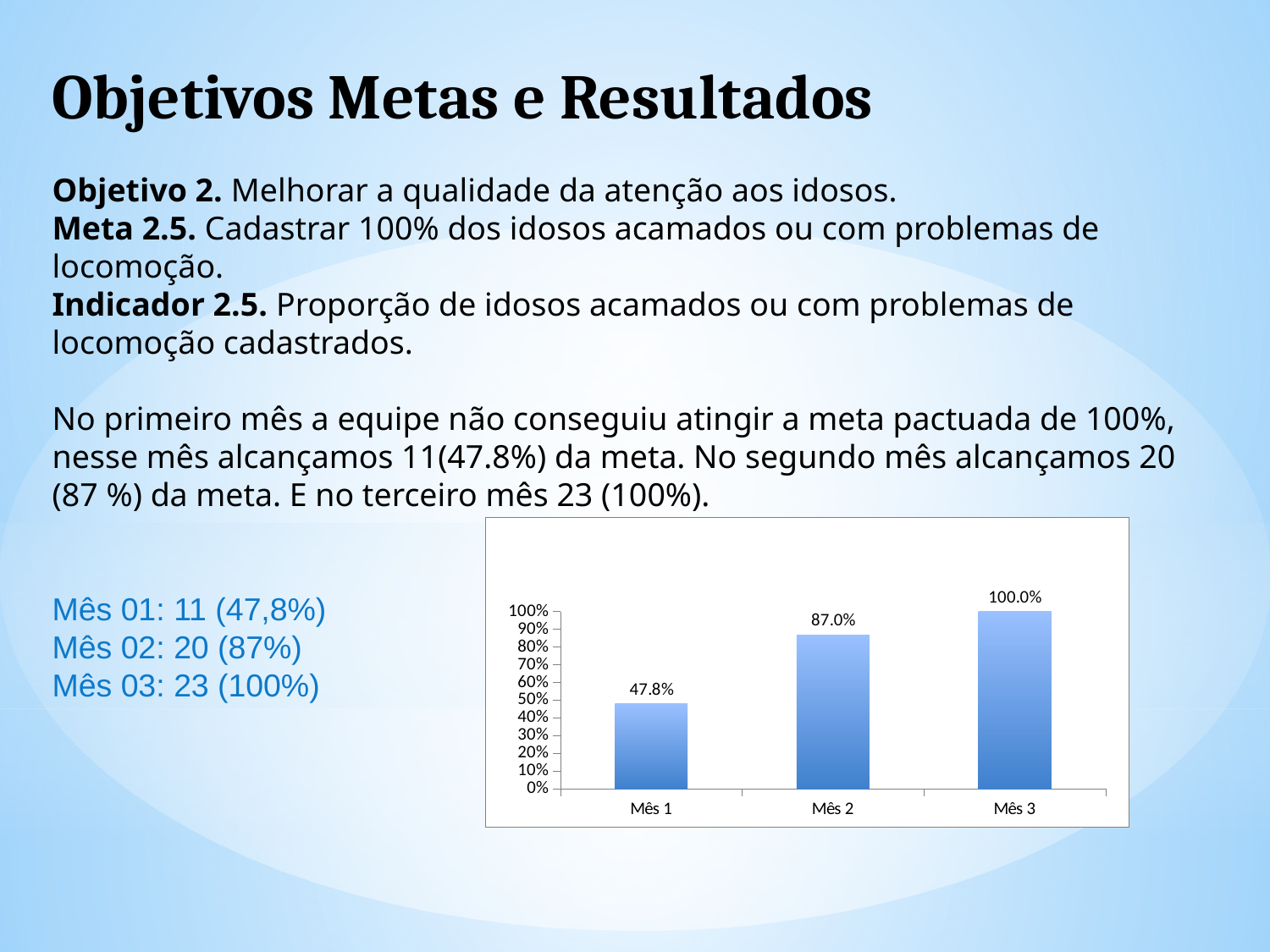
Do the values rise or fall from Mês 1 to Mês 3? rise Which month has the highest value? Mês 3 What is the value for Mês 1? 47.8% What is the difference between the values for Mês 2 and Mês 1? 39.2% Is the value for Mês 1 greater or less than 50%? less What kind of chart is shown on the slide? bar chart How many categories are shown on the x axis? 3 What is the difference between the values for Mês 3 and Mês 2? 13.0% What is the value for Mês 3? 100.0% What is the value for Mês 2? 87.0% Which is larger, the value for Mês 1 or the value for Mês 2? Mês 2 Which month has the lowest value? Mês 1